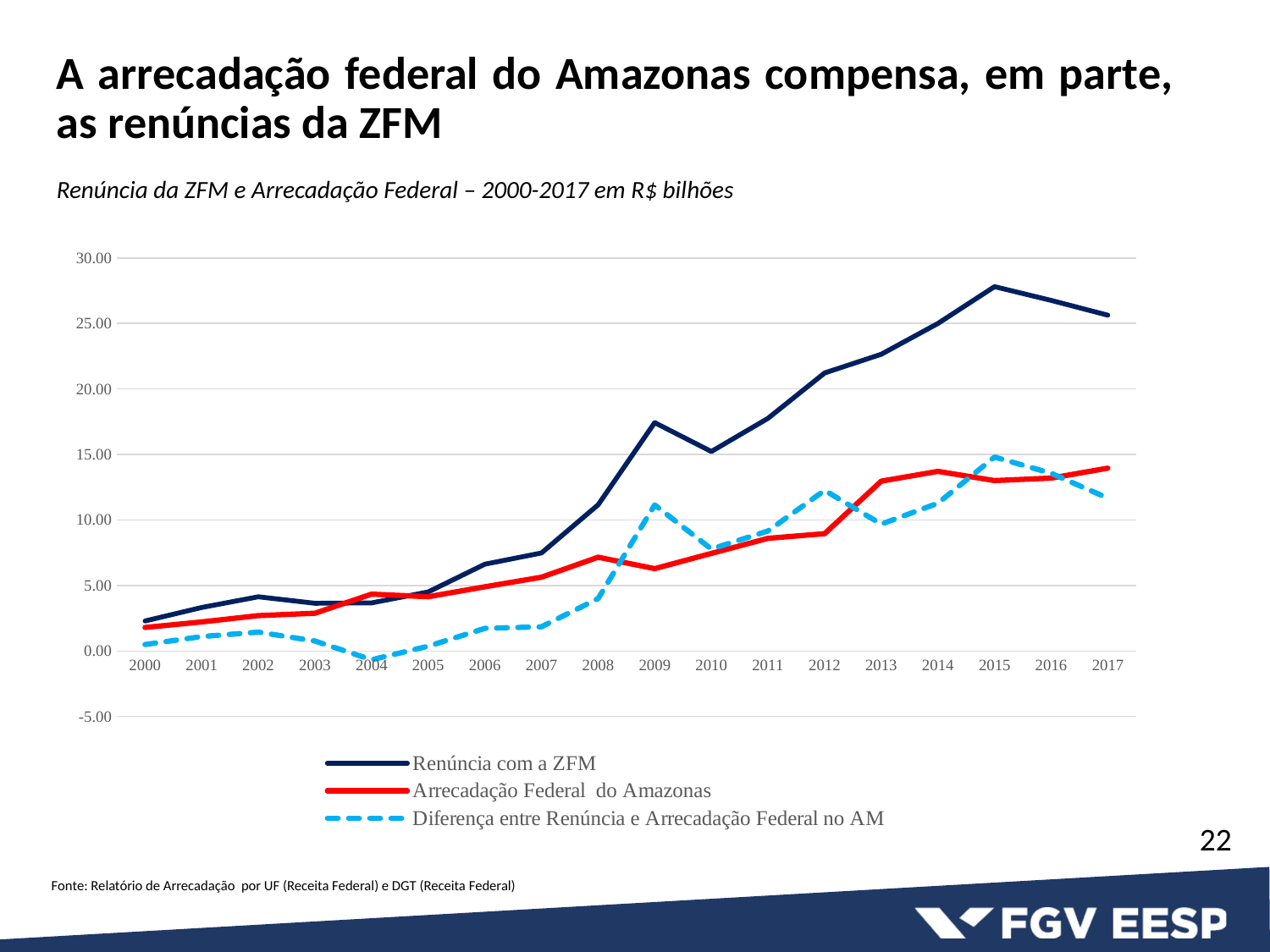
Does the 'Renúncia com a ZFM' series generally rise or fall between 2000 and 2015? rise Is the value of 'Renúncia com a ZFM' in 2015 greater or less than 25.00? greater Is the value of 'Renúncia com a ZFM' in 2000 greater or less than 5.00? less In which year is the 'Diferença entre Renúncia e Arrecadação Federal no AM' series at its lowest? 2004 What kind of chart is shown on the slide? line chart Is the value of 'Arrecadação Federal do Amazonas' in 2013 greater or less than 10.00? greater How many years are plotted along the x axis? 18 In which year does the 'Renúncia com a ZFM' series reach its highest value? 2015 How many series does the legend list? 3 Which series is drawn with a dashed line? Diferença entre Renúncia e Arrecadação Federal no AM In 2017, which series has the larger value: 'Renúncia com a ZFM' or 'Arrecadação Federal do Amazonas'? Renúncia com a ZFM